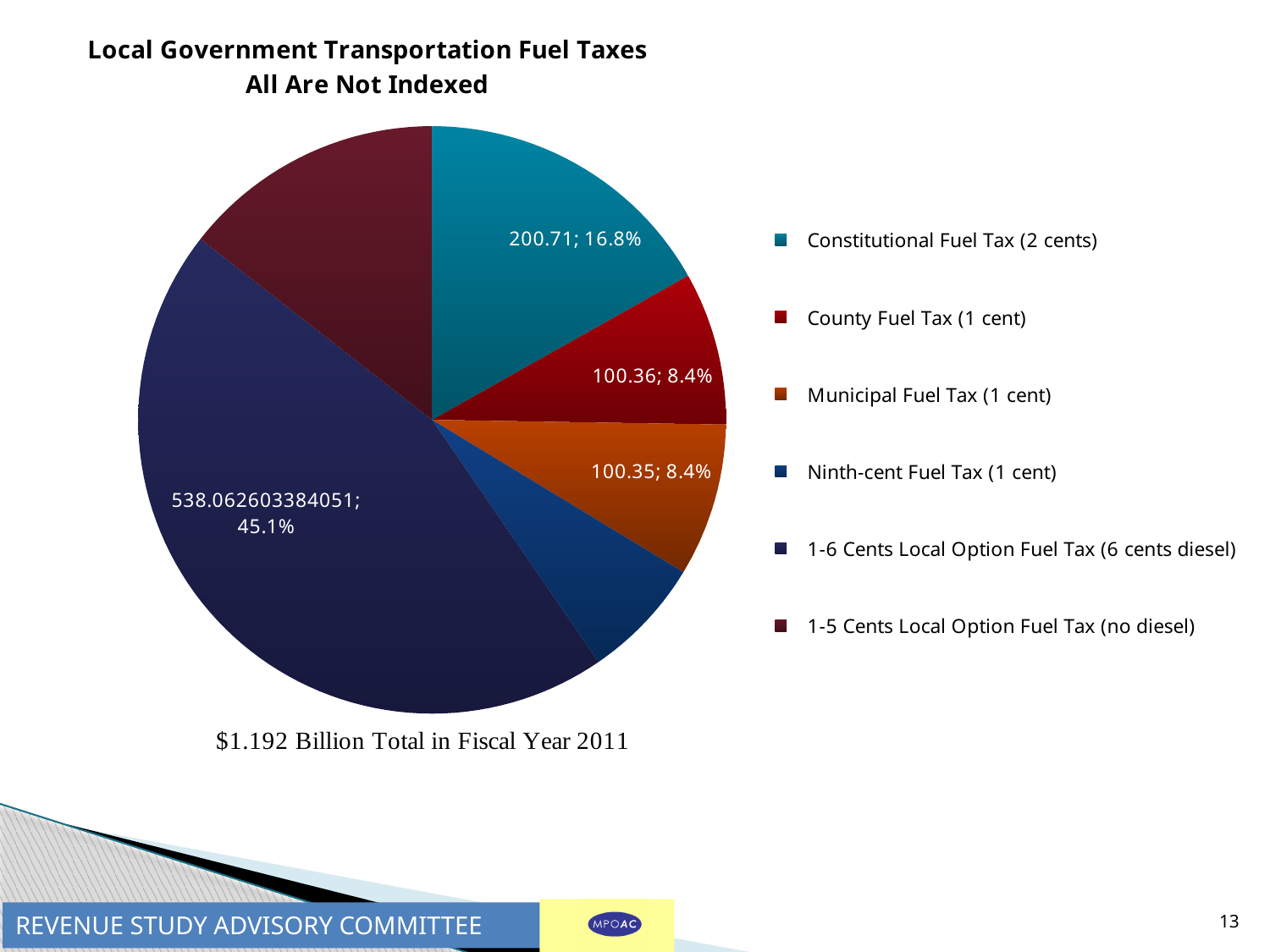
What kind of chart is shown on the slide? Pie chart Which category has the largest slice of the pie? 1-6 Cents Local Option Fuel Tax (6 cents diesel) What value is shown for the Municipal Fuel Tax (1 cent) slice? 100.35 How many slices does the pie chart have? 6 What value is shown for the County Fuel Tax (1 cent) slice? 100.36 What share of the pie does the Constitutional Fuel Tax (2 cents) slice represent? 16.8% What is the difference between the Constitutional Fuel Tax value and the County Fuel Tax value? 100.35 What share of the pie does the 1-6 Cents Local Option Fuel Tax (6 cents diesel) slice represent? 45.1% What value is shown for the Constitutional Fuel Tax (2 cents) slice? 200.71 What total amount does the caption below the pie chart state for Fiscal Year 2011? $1.192 Billion Which slice is larger: 1-5 Cents Local Option Fuel Tax (no diesel) or County Fuel Tax (1 cent)? 1-5 Cents Local Option Fuel Tax (no diesel) How many entries does the legend list? 6